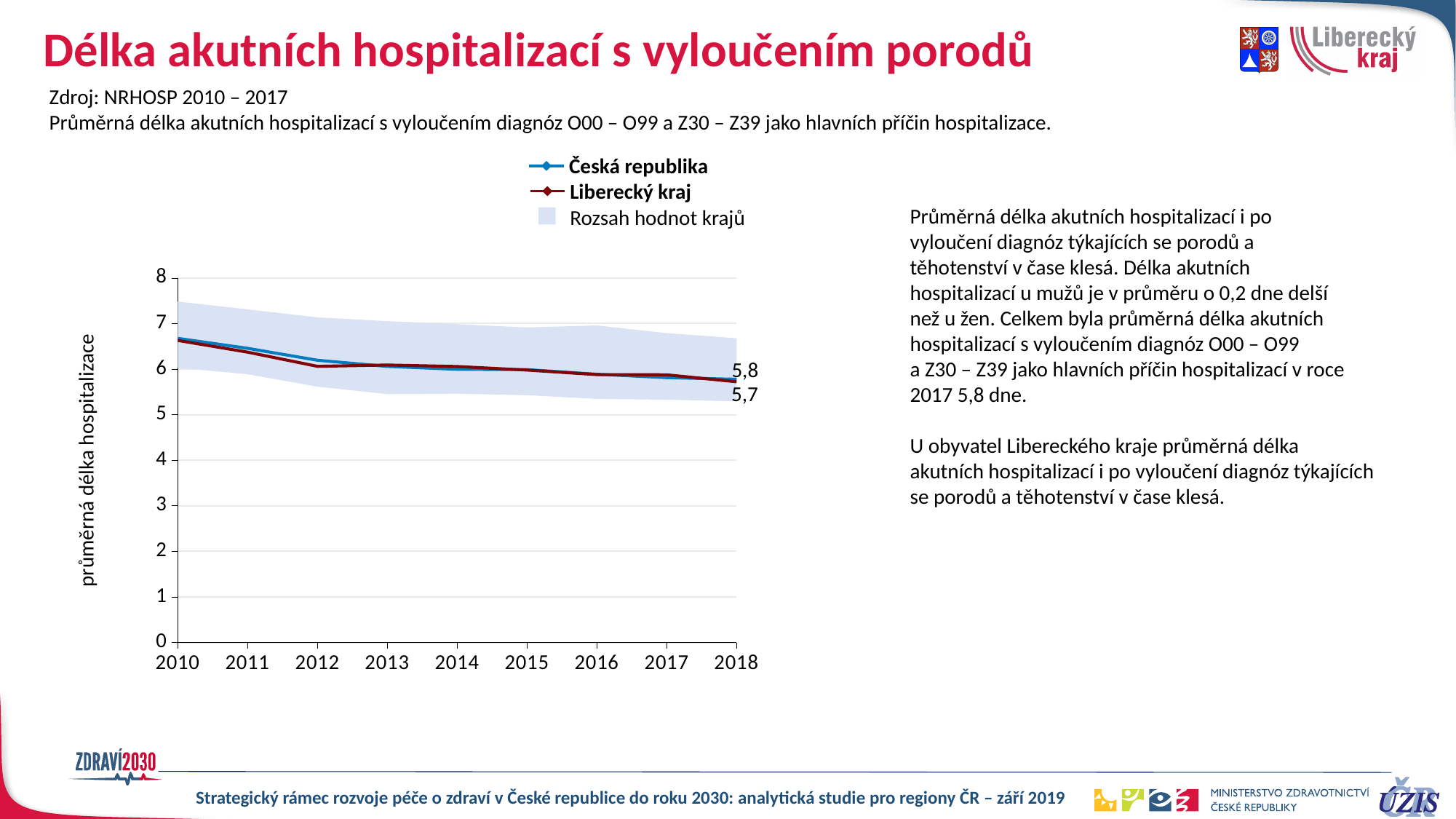
Do the values for Česká republika rise or fall from 2010 to the end of the series? fall Is the value for Česká republika in 2014 greater or less than 7? less What is the lower of the two data labels printed at the right end of the lines? 5,7 Is the value for Česká republika in 2010 greater or less than 6? greater In 2012, which series has the higher value, Česká republika or Liberecký kraj? Česká republika Is the value for Liberecký kraj in 2012 greater or less than 7? less What is the difference between the two data labels printed at the right end of the lines, 5,8 and 5,7? 0,1 What kind of chart is shown on the slide? line chart How many year labels are shown on the x axis? 9 How many entries does the chart legend list? 3 What is the label of the y axis? průměrná délka hospitalizace What is the higher of the two data labels printed at the right end of the lines? 5,8